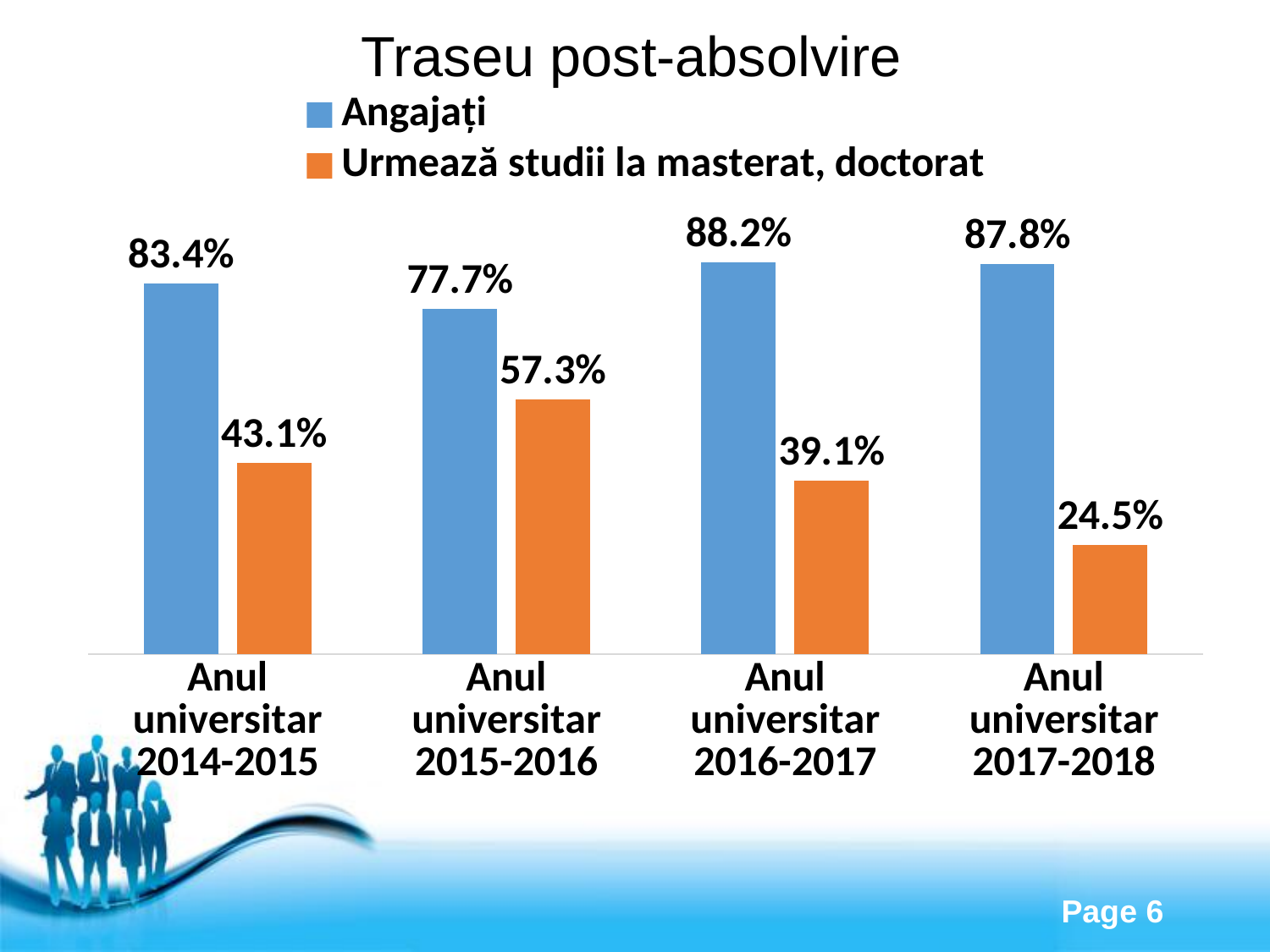
How many series does the legend list? 2 What is the title of the chart? Traseu post-absolvire What is the value for Angajați in Anul universitar 2014-2015? 83.4% What is the value for Urmează studii la masterat, doctorat in Anul universitar 2015-2016? 57.3% How many academic years are shown on the x axis? 4 In which academic year is the Angajați value highest? Anul universitar 2016-2017 In which academic year is the Urmează studii la masterat, doctorat value lowest? Anul universitar 2017-2018 Which is larger: the Angajați value in 2014-2015 or the Angajați value in 2015-2016? 2014-2015 What kind of chart is shown on the slide? Bar chart What is the difference between the Angajați and Urmează studii la masterat, doctorat values in Anul universitar 2016-2017? 49.1% Does the Urmează studii la masterat, doctorat value rise or fall from Anul universitar 2015-2016 to Anul universitar 2017-2018? Fall What is the value for Urmează studii la masterat, doctorat in Anul universitar 2017-2018? 24.5%